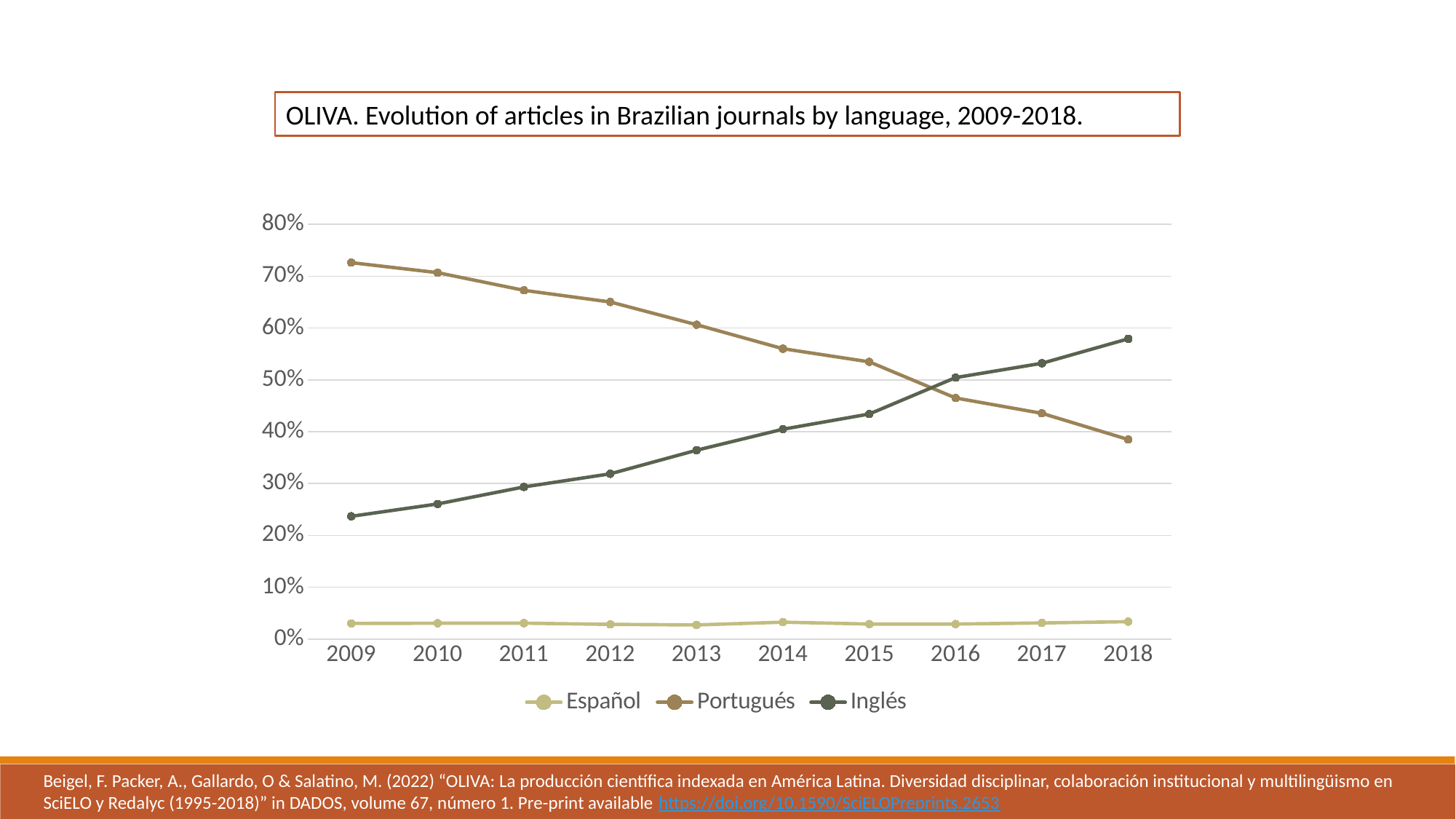
Is the value for Inglés in 2009 greater or less than 30%? less What kind of chart is shown on the slide? line chart Does the Inglés line rise or fall from 2009 to 2018? rise How many years are plotted along the x axis? 10 Is the value for Portugués in 2009 greater or less than 70%? greater In 2018, which is larger: Inglés or Portugués? Inglés In 2015, which is larger: Portugués or Inglés? Portugués How many series does the legend list? 3 In which year is the Inglés value highest? 2018 Is the value for Español in 2018 greater or less than 10%? less Does the Portugués line rise or fall from 2009 to 2018? fall